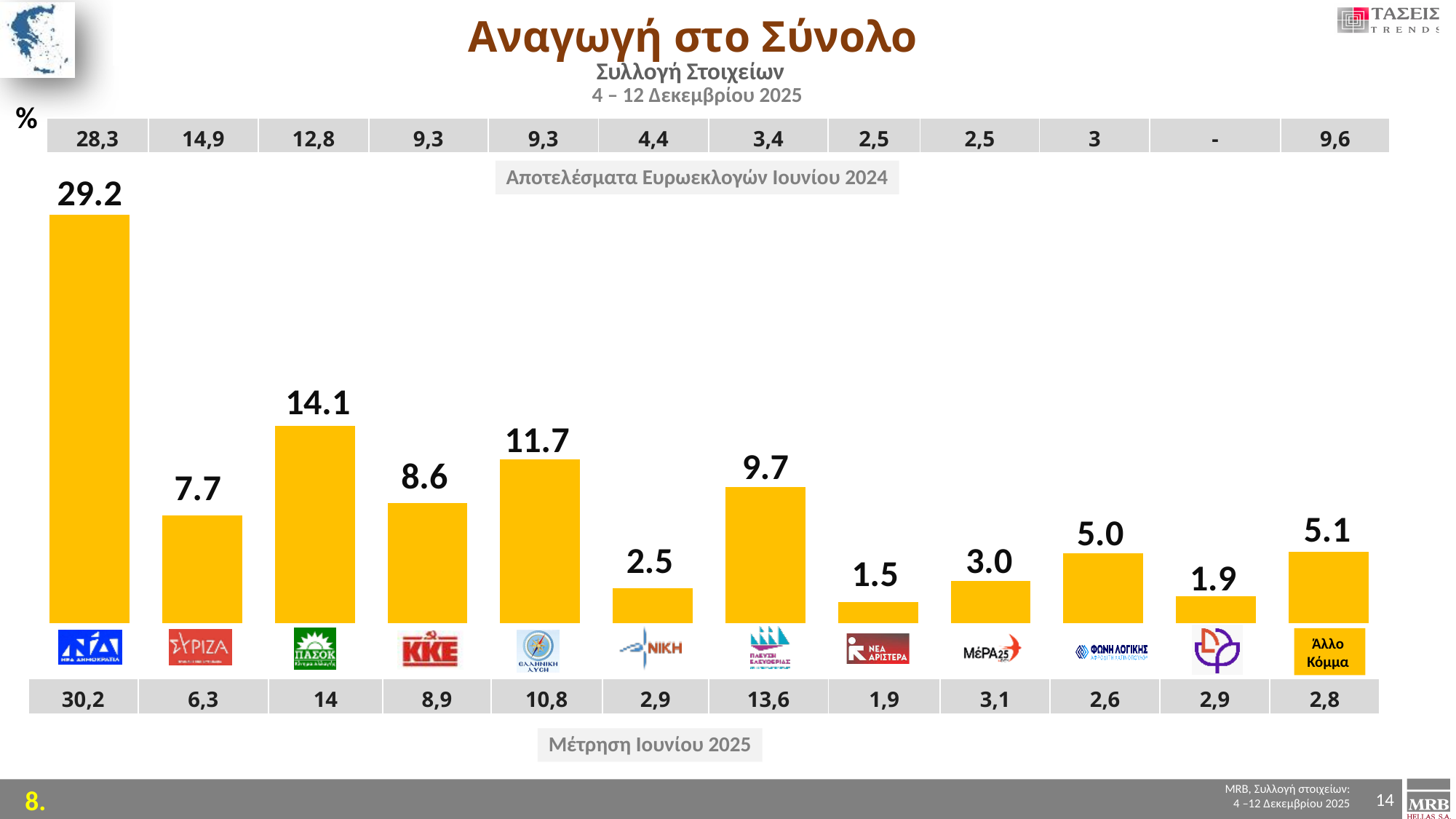
Which is larger, the bar for Ελληνική Λύση or the bar for Πλεύση Ελευθερίας? Ελληνική Λύση What is the difference between the ΝΔ bar and the ΠΑΣΟΚ bar? 15.1 What value is shown for the ΚΚΕ bar? 8.6 What is the difference between the ΝΙΚΗ bar and the ΜέΡΑ25 bar? 0.5 How many bars are plotted in the chart? 12 Which party has the highest bar in the chart? ΝΔ (Νέα Δημοκρατία) Which party has the lowest bar in the chart? Νέα Αριστερά What value is shown for the Άλλο Κόμμα bar? 5.1 What value is shown for the ΣΥΡΙΖΑ bar? 7.7 What colour are the bars in the chart? Yellow What kind of chart is shown on the slide? Bar chart What value is shown for the ΠΑΣΟΚ bar? 14.1